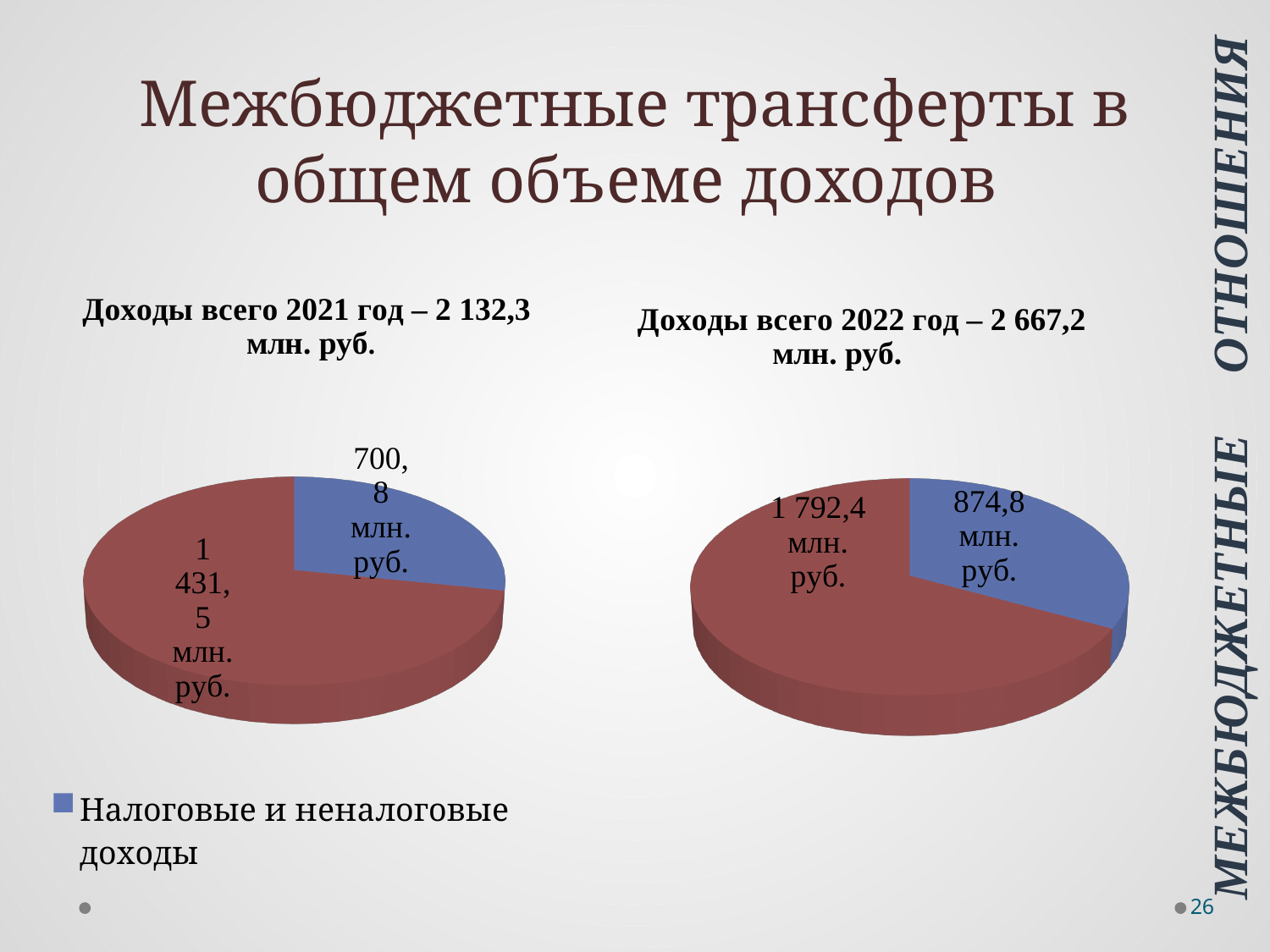
In the 2022 chart (right), which slice is the largest? The red slice (1 792,4 млн. руб.) In the 2021 chart (left), what is the value of the slice for Налоговые и неналоговые доходы? 700,8 млн. руб. What total income is stated in the title of the 2022 chart (right)? 2 667,2 млн. руб. In the 2022 chart (right), what is the difference between the red slice and the Налоговые и неналоговые доходы slice? 917,6 млн. руб. In the 2021 chart (left), what is the difference between the red slice and the Налоговые и неналоговые доходы slice? 730,7 млн. руб. In the 2021 chart (left), what is the value of the larger (red) slice? 1 431,5 млн. руб. What colour is the slice for Налоговые и неналоговые доходы in both charts? Blue How many slices does the 2021 chart (left) have? 2 In the 2022 chart (right), what is the value of the slice for Налоговые и неналоговые доходы? 874,8 млн. руб. In the 2022 chart (right), what is the value of the larger (red) slice? 1 792,4 млн. руб. Which chart has the larger value for Налоговые и неналоговые доходы, the 2021 chart or the 2022 chart? The 2022 chart What kind of chart is used on this slide? Pie chart